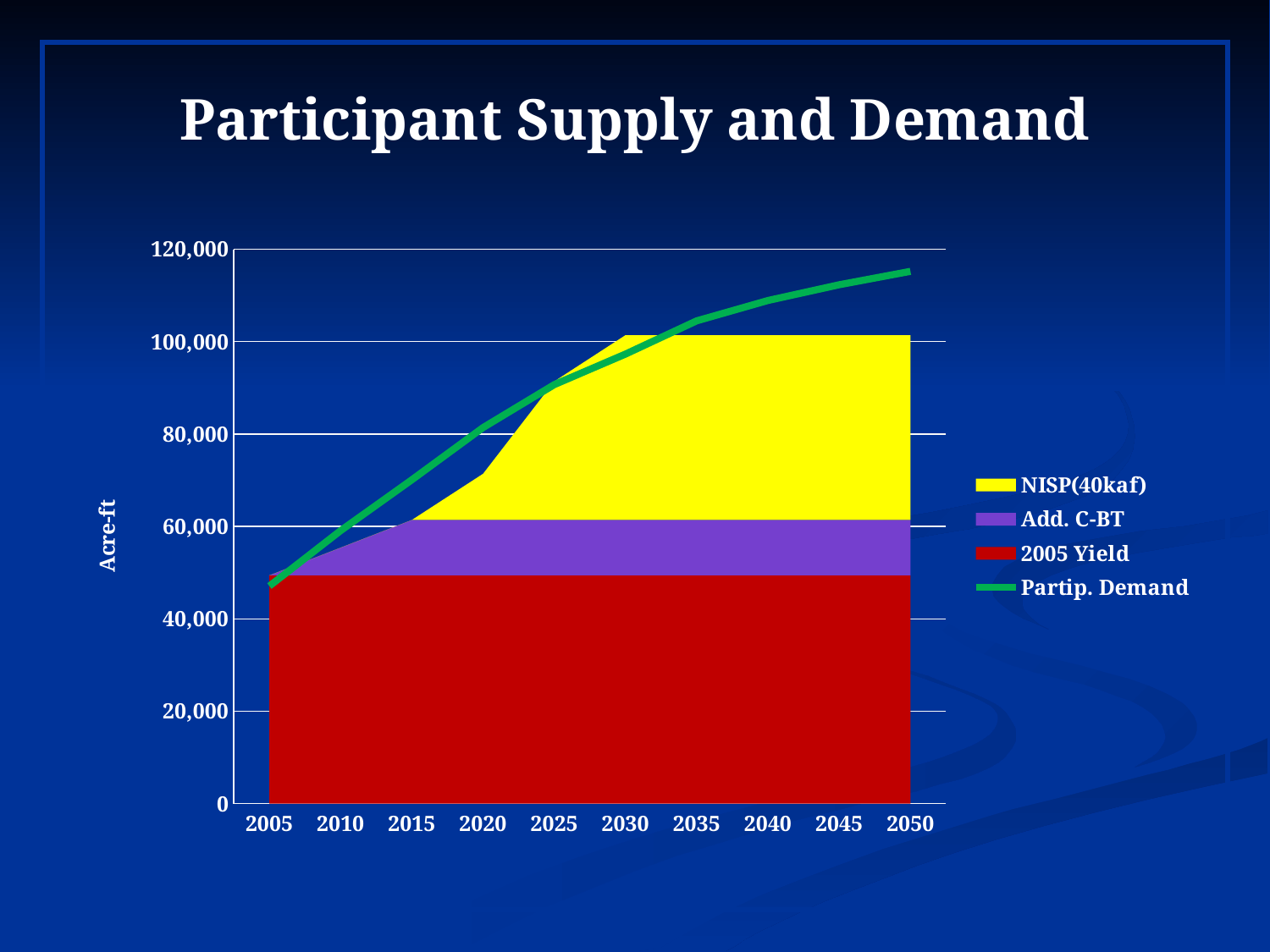
How many series does the legend list? 4 Is the total stacked supply in 2050 greater or less than 80,000? greater Does the Partip. Demand line rise or fall from 2005 to 2050? Rises Is the 2005 Yield value in 2050 greater or less than 60,000? less What is the title of the chart? Participant Supply and Demand Is the Partip. Demand value in 2005 greater or less than 60,000? less In 2050, is the Partip. Demand line above or below the top of the stacked supply area? Above How many year labels are shown along the x axis? 10 What kind of chart is shown on the slide? Area chart with a line What is the label on the y axis? Acre-ft